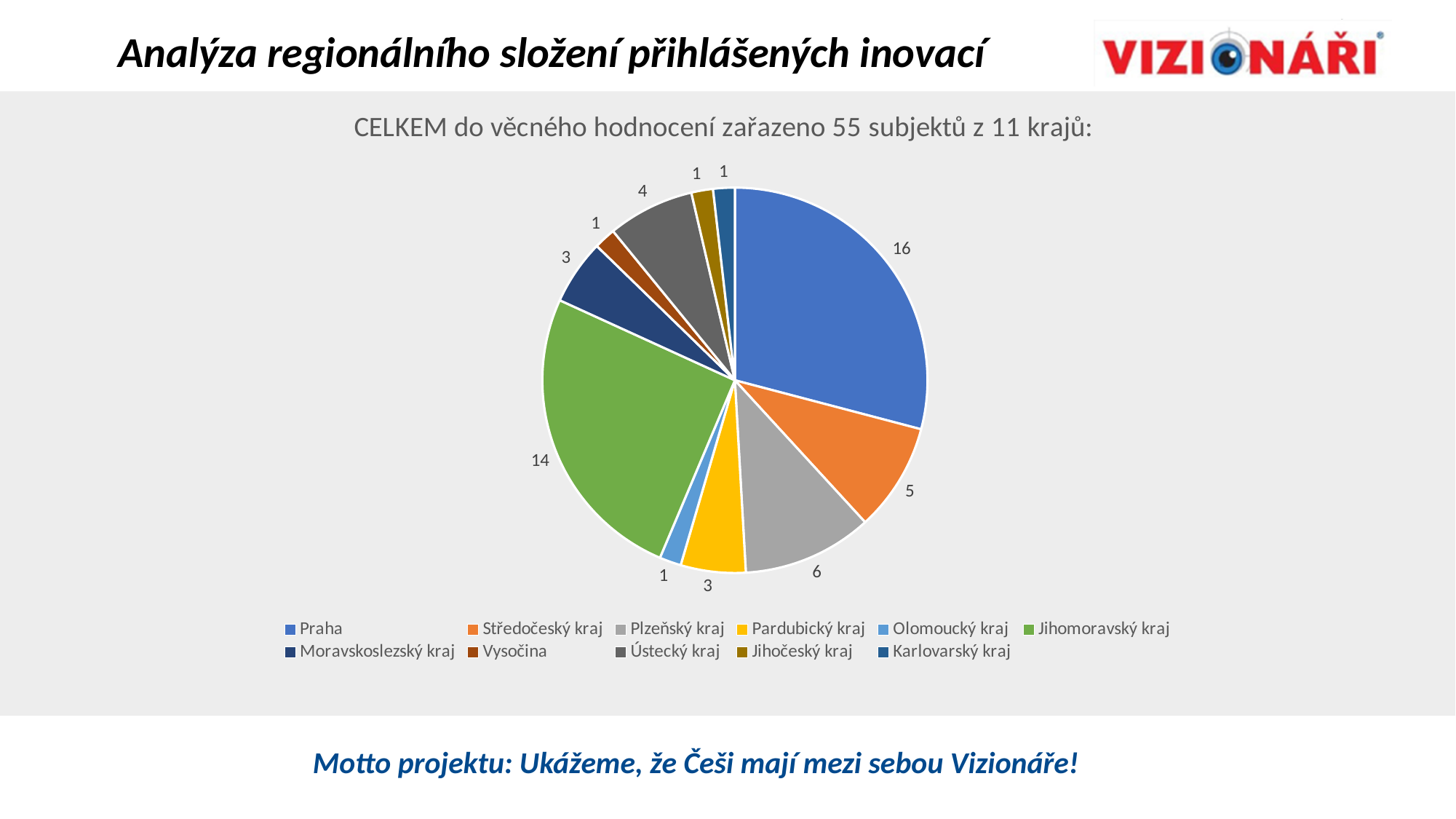
How many regions (slices) does the pie chart show? 11 Which is larger, the value for Středočeský kraj or the value for Plzeňský kraj? Plzeňský kraj What is the value for Ústecký kraj in the pie chart? 4 What is the difference between the values for Ústecký kraj and Pardubický kraj? 1 What is the value for Jihomoravský kraj in the pie chart? 14 What is the value for Plzeňský kraj in the pie chart? 6 Which region has the largest slice in the pie chart? Praha What is the difference between the values for Praha and Jihomoravský kraj? 2 What colour is the slice for Jihomoravský kraj? green What is the total of all slices in the pie chart? 55 What is the value for Praha in the pie chart? 16 What kind of chart is shown on the slide? pie chart